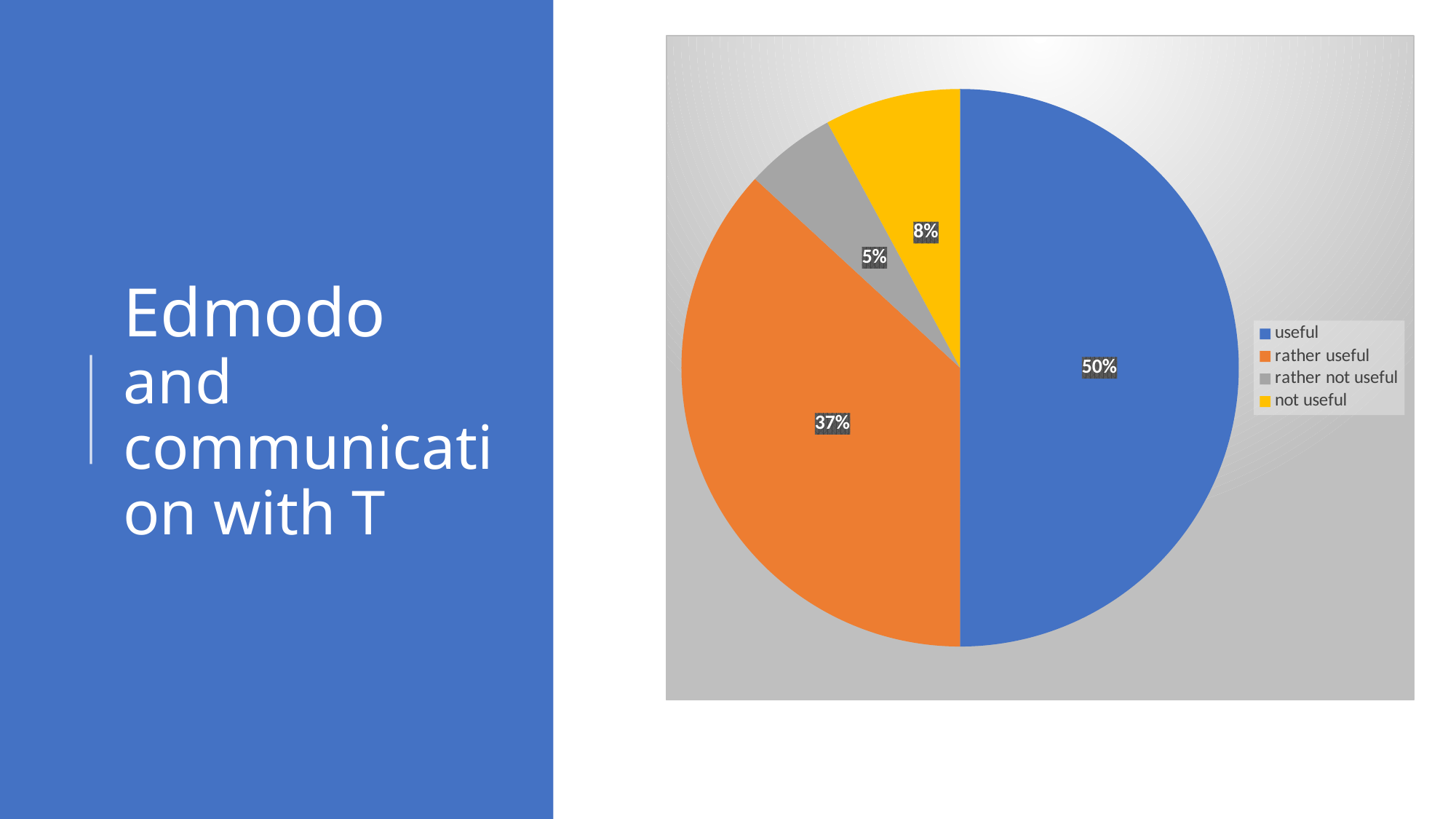
What share of the pie is labelled "rather useful"? 37% What share of the pie is labelled "rather not useful"? 5% How many categories does the pie chart have? 4 What colour is the "rather useful" slice? orange Which is larger, the "not useful" slice or the "rather not useful" slice? not useful What is the difference between the "useful" and "rather useful" shares? 13% Which category has the smallest slice of the pie? rather not useful What kind of chart is shown on the slide? pie chart What is the combined share of "useful" and "rather useful"? 87% What share of the pie is labelled "not useful"? 8% Which category has the largest slice of the pie? useful